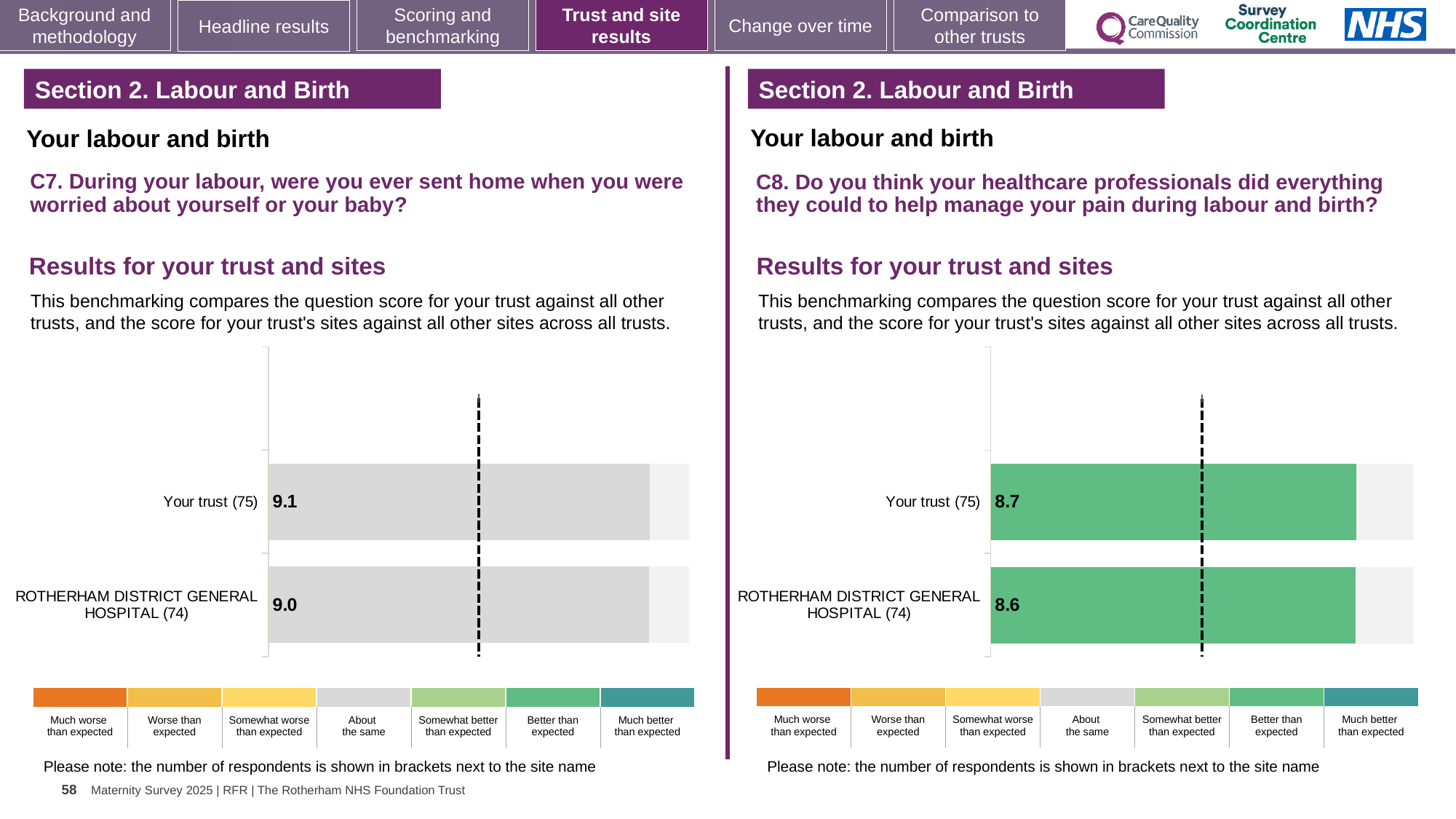
In the C8 chart on the right, what is the difference between the Your trust score and the ROTHERHAM DISTRICT GENERAL HOSPITAL score? 0.1 What kind of chart is used for the C8 results on the right? Bar chart In the C8 chart on the right, which has the lower score, Your trust or ROTHERHAM DISTRICT GENERAL HOSPITAL? ROTHERHAM DISTRICT GENERAL HOSPITAL In the C7 chart on the left, which has the higher score, Your trust or ROTHERHAM DISTRICT GENERAL HOSPITAL? Your trust In the C7 chart on the left, what is the score for Your trust (75)? 9.1 In the C7 chart on the left, what is the difference between the Your trust score and the ROTHERHAM DISTRICT GENERAL HOSPITAL score? 0.1 In the C8 chart on the right, what is the score for ROTHERHAM DISTRICT GENERAL HOSPITAL (74)? 8.6 How many bars are plotted in the C7 chart on the left? 2 In the C7 chart on the left, which benchmark category does the grey colour of the bars represent according to the legend? About the same In the C8 chart on the right, which benchmark category does the green colour of the bars represent according to the legend? Better than expected In the C7 chart on the left, what is the score for ROTHERHAM DISTRICT GENERAL HOSPITAL (74)? 9.0 In the C8 chart on the right, what is the score for Your trust (75)? 8.7